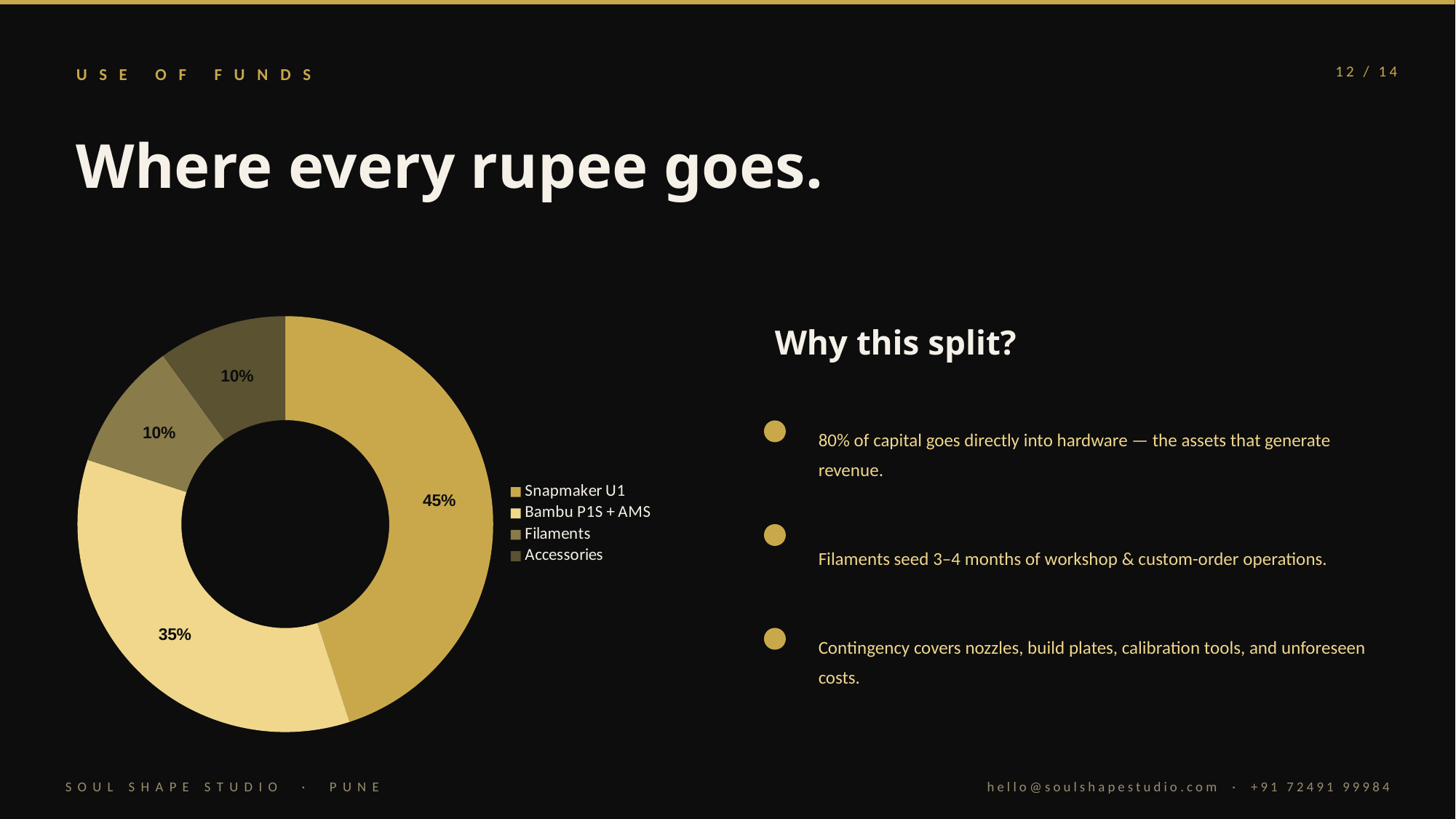
Which legend entry is shown in the lightest yellow colour? Bambu P1S + AMS What is the difference in percentage points between the Snapmaker U1 and Bambu P1S + AMS shares? 10 What kind of chart is shown on the slide? Pie (donut) chart What share of funds goes to Snapmaker U1? 45% What share of funds goes to Filaments? 10% What share of funds goes to Accessories? 10% What share of funds goes to Bambu P1S + AMS? 35% What is the combined share of Snapmaker U1 and Bambu P1S + AMS? 80% Which category receives the largest share of funds? Snapmaker U1 How many categories are shown in the chart? 4 How many entries does the legend list? 4 Which is larger, the share for Bambu P1S + AMS or the share for Filaments? Bambu P1S + AMS